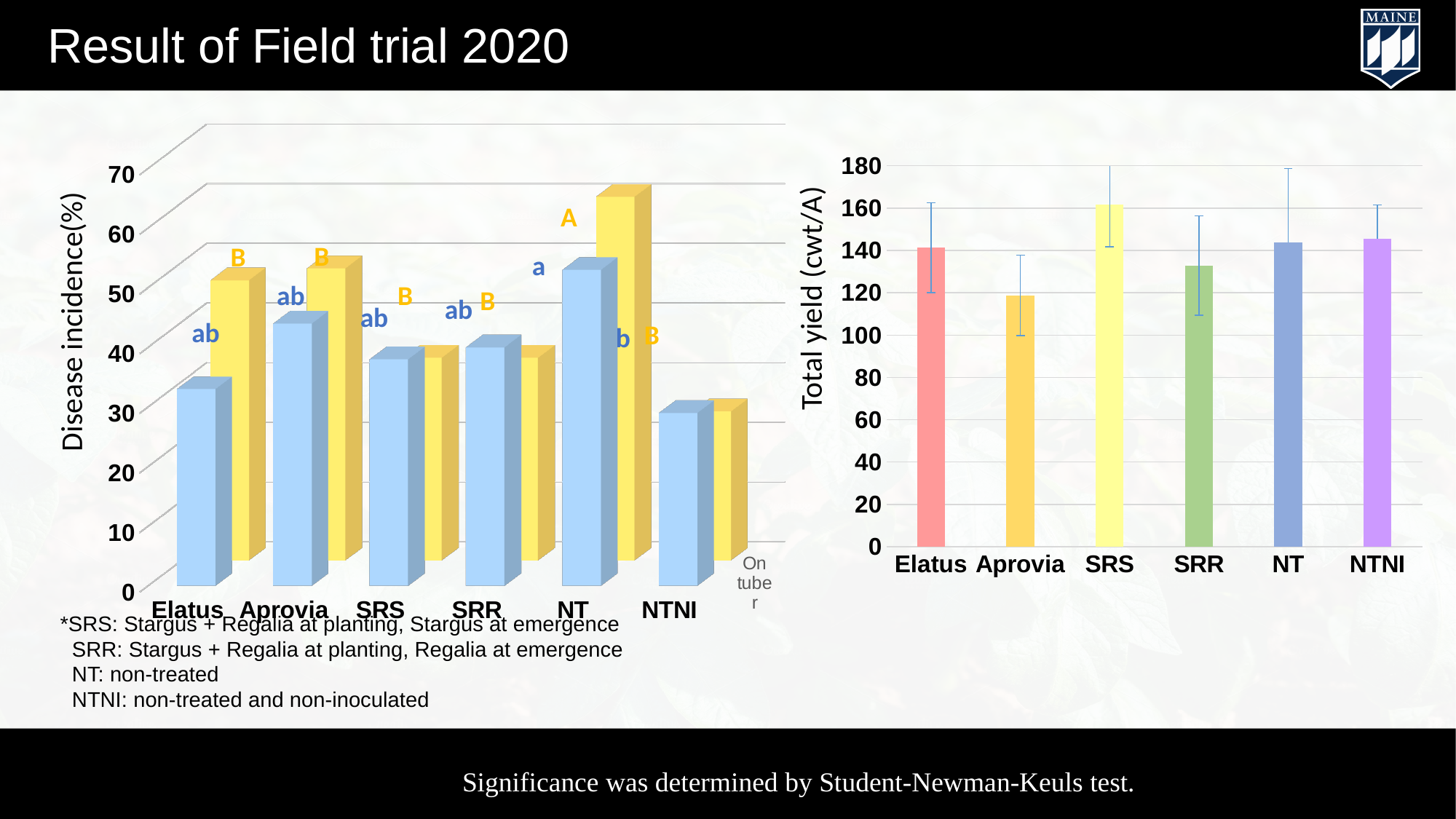
What kind of chart is the Total yield (cwt/A) chart on the right? bar chart In the Disease incidence (%) chart on the left, is the blue bar for NT greater or less than 50? greater In the Total yield (cwt/A) chart on the right, which treatment has the highest total yield? SRS What is the y-axis title of the chart on the right? Total yield (cwt/A) In the Total yield (cwt/A) chart on the right, which treatment has the lowest total yield? Aprovia How many treatments are shown on the x axis of the Total yield (cwt/A) chart on the right? 6 In the Total yield (cwt/A) chart on the right, which is larger, the value for SRS or the value for SRR? SRS In the Total yield (cwt/A) chart on the right, is the value for Aprovia greater or less than 100? greater In the Total yield (cwt/A) chart on the right, is the value for SRR greater or less than 120? greater In the Disease incidence (%) chart on the left, which treatment has the highest blue bar? NT In the Disease incidence (%) chart on the left, which treatment has the lowest yellow bar? NTNI